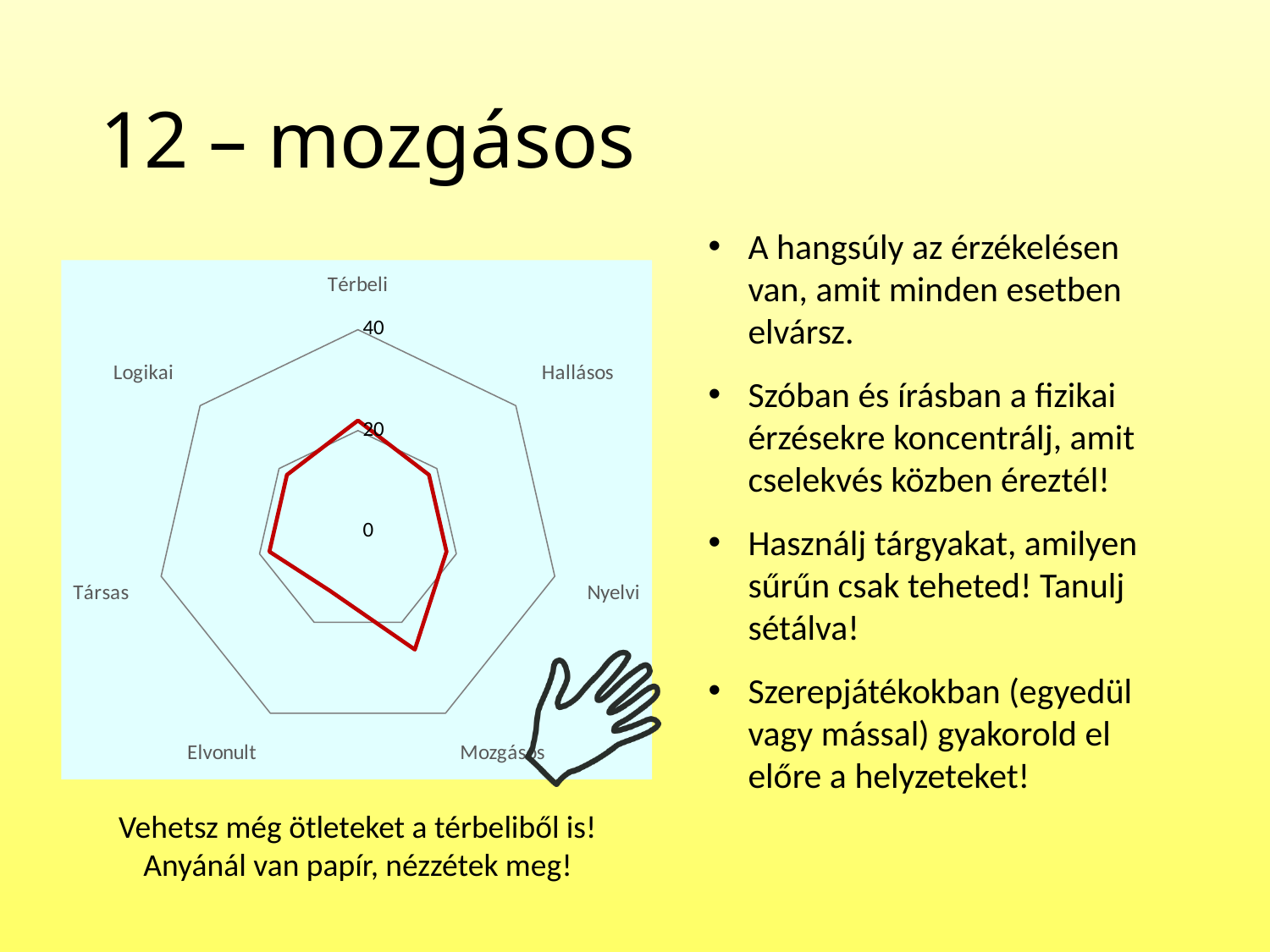
What is the maximum value shown on the radar chart's axis scale? 40 Is the value for Térbeli greater or less than 40? less Is the value for Mozgásos greater or less than 20? greater Is the value for Mozgásos greater or less than 40? less What colour is the data line on the radar chart? red Which is larger, the value for Mozgásos or the value for Elvonult? Mozgásos Which category has the highest value on the radar chart? Mozgásos Which category has the lowest value on the radar chart? Elvonult What kind of chart is shown on the slide? radar chart How many categories (axes) does the radar chart have? 7